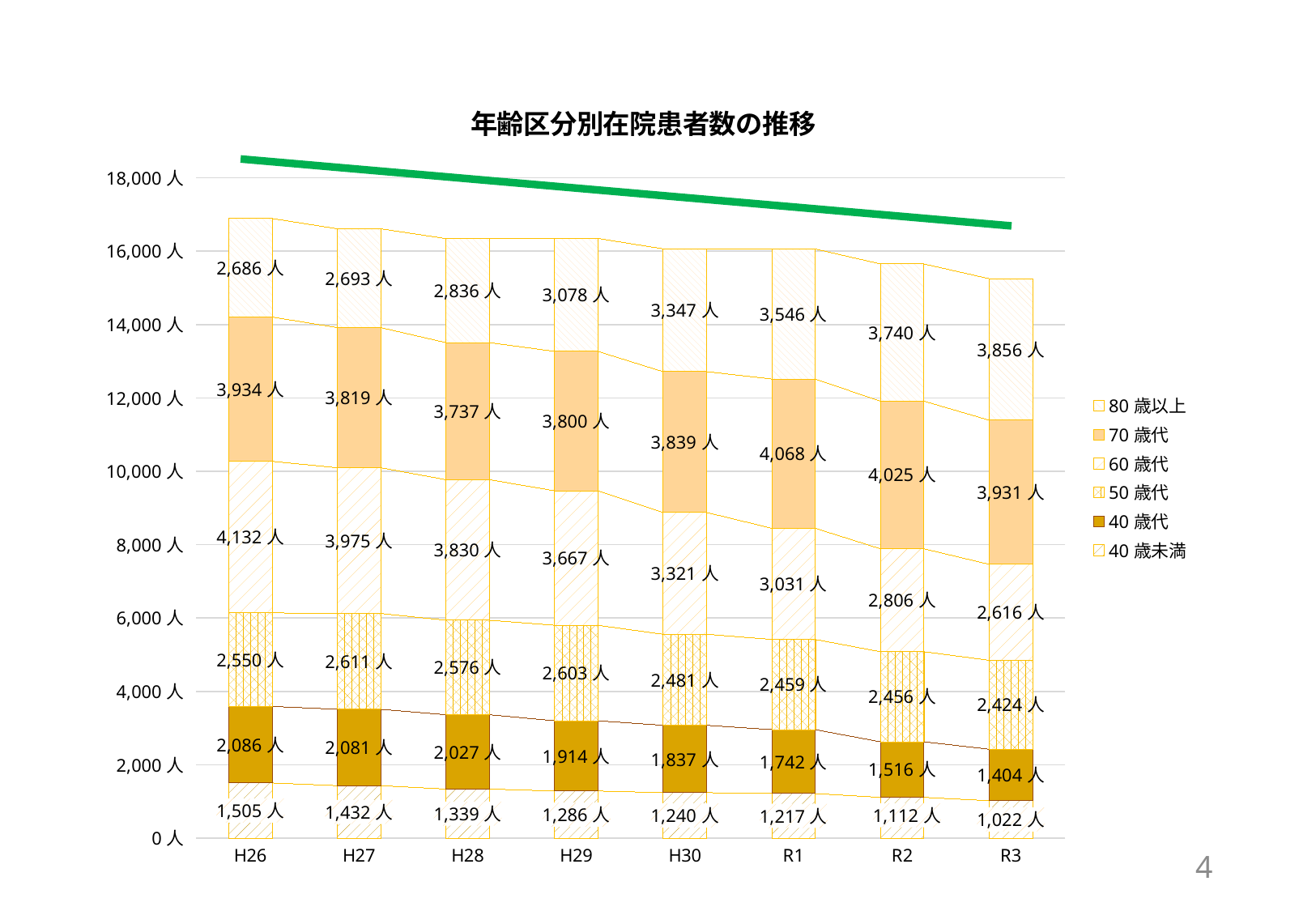
Which is larger, the 50 歳代 value in H27 or in H30? H27 What is the total of the stacked bar for R3? 15,253 人 How many series does the legend list? 6 What kind of chart is shown? Stacked bar chart How many years are shown on the x axis? 8 What is the value for 80 歳以上 in R3? 3,856 人 What is the value for 40 歳未満 in H26? 1,505 人 Does the 40 歳未満 value rise or fall from H26 to R3? Fall What is the difference between the 80 歳以上 values in R3 and H26? 1,170 人 In which year is the 60 歳代 value highest? H26 In which year is the 40 歳代 value lowest? R3 What is the value for 70 歳代 in R1? 4,068 人